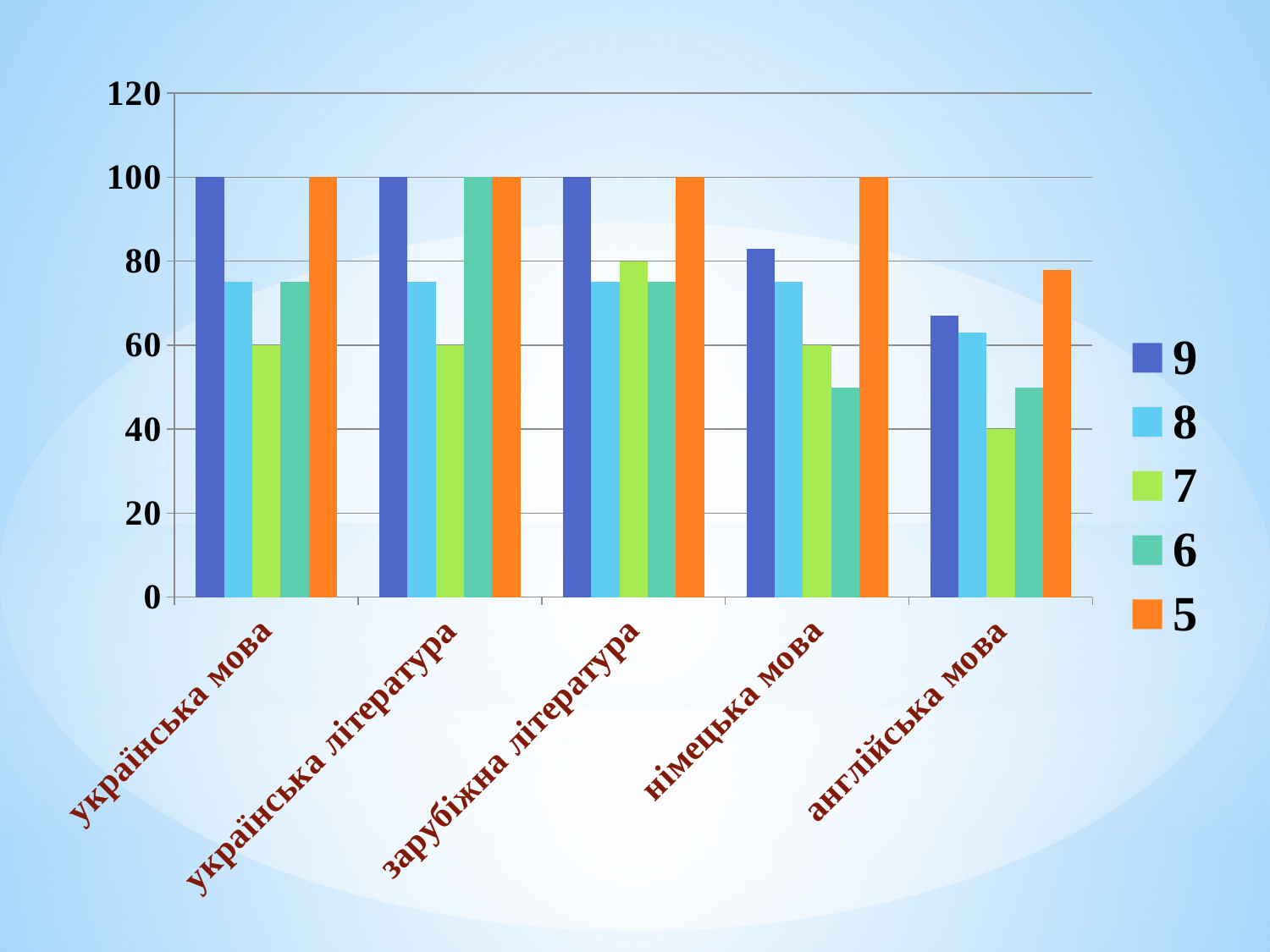
Is the value for series 5 in англійська мова greater or less than 60? greater In the category німецька мова, which is larger: series 9 or series 7? 9 How many categories are shown on the x axis? 5 What is the value for series 5 in the category німецька мова? 100 For series 7, which category has the lowest value? англійська мова What kind of chart is shown on the slide? bar chart Is the value for series 8 in українська мова greater or less than 80? less What is the value for series 7 in the category англійська мова? 40 What is the value for series 9 in the category українська мова? 100 Is the value for series 9 in англійська мова greater or less than 80? less How many series does the legend list? 5 What is the value for series 7 in the category українська мова? 60